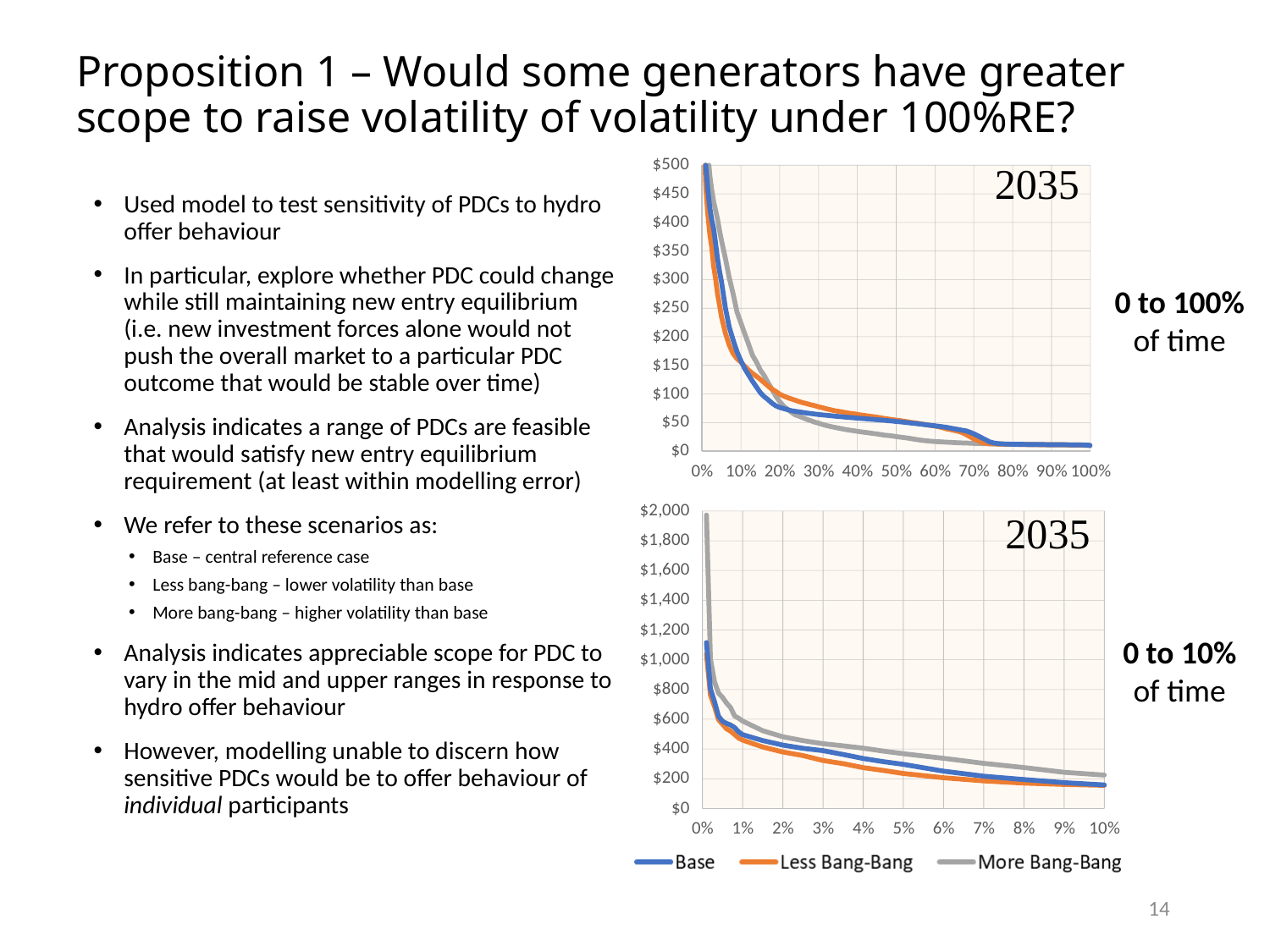
In the top chart (0 to 100% of time), is the More Bang-Bang value at 50% greater or less than $50? less Which series are listed in the legend? Base, Less Bang-Bang, More Bang-Bang What year is labelled on both charts? 2035 How many series does the legend list for the charts? 3 In the bottom chart (0 to 10% of time), is the More Bang-Bang value at 5% greater or less than $200? greater In the bottom chart (0 to 10% of time), is the Base value at 10% greater or less than $200? less In the bottom chart (0 to 10% of time), do the values rise or fall as the x axis increases? Fall In the top chart (0 to 100% of time), do the values rise or fall as the x axis increases? Fall What kind of chart is the top chart (0 to 100% of time)? Line chart In the bottom chart (0 to 10% of time), which series is higher at 5%: More Bang-Bang or Less Bang-Bang? More Bang-Bang In the top chart (0 to 100% of time), which series is higher at 50%: Base or More Bang-Bang? Base